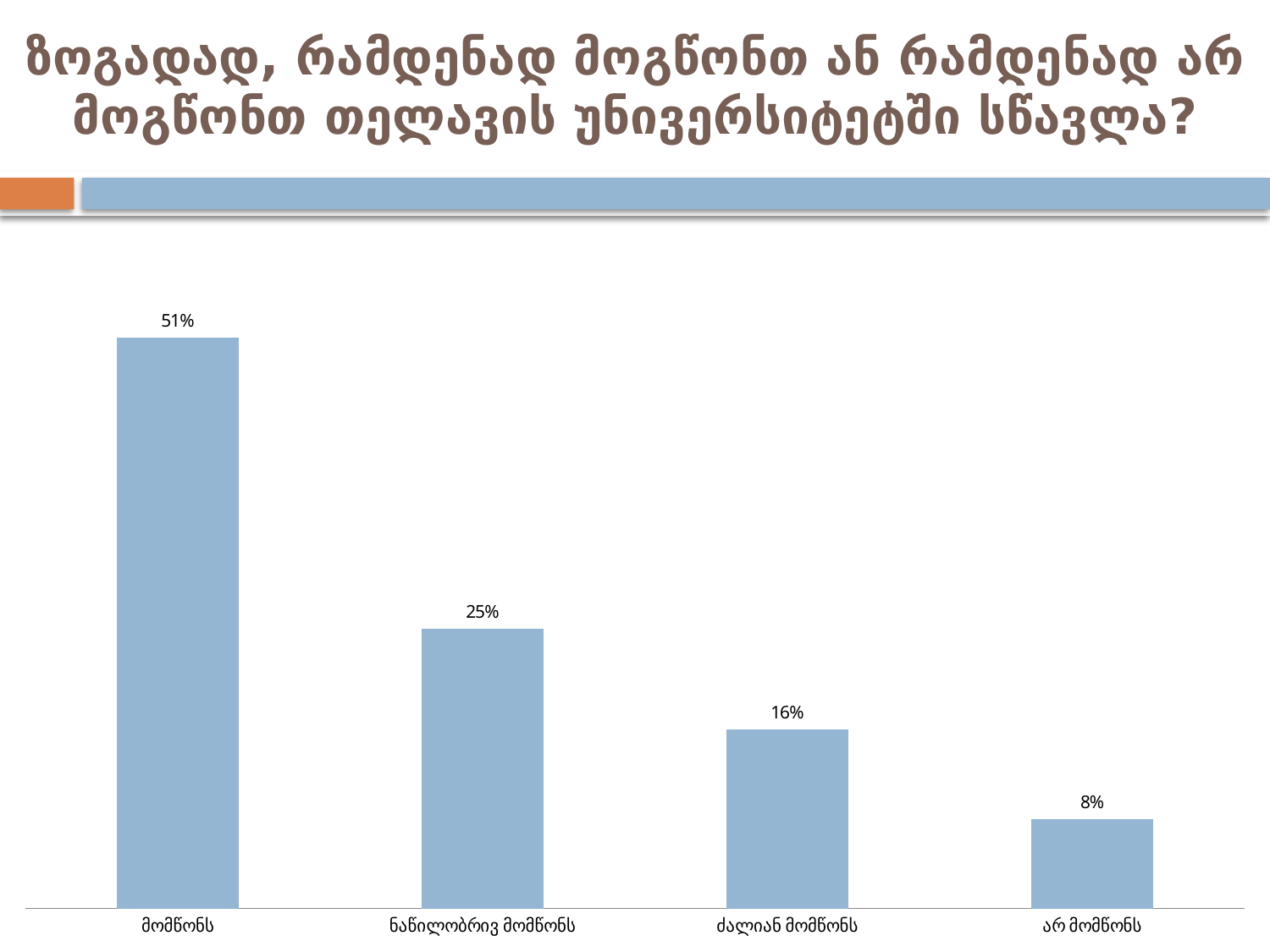
What value is shown for the category "მომწონს"? 51% Do the values rise or fall from left to right across the categories? Fall What value is shown for the category "ნაწილობრივ მომწონს"? 25% What is the difference between the values for "მომწონს" and "ნაწილობრივ მომწონს"? 26% What value is shown for the category "ძალიან მომწონს"? 16% Which is larger, the value for "ნაწილობრივ მომწონს" or the value for "ძალიან მომწონს"? ნაწილობრივ მომწონს Which category has the lowest value? არ მომწონს What kind of chart is shown on the slide? Bar chart What is the difference between the values for "ძალიან მომწონს" and "არ მომწონს"? 8% What value is shown for the category "არ მომწონს"? 8% Which category has the highest value? მომწონს How many categories are shown in the chart? 4